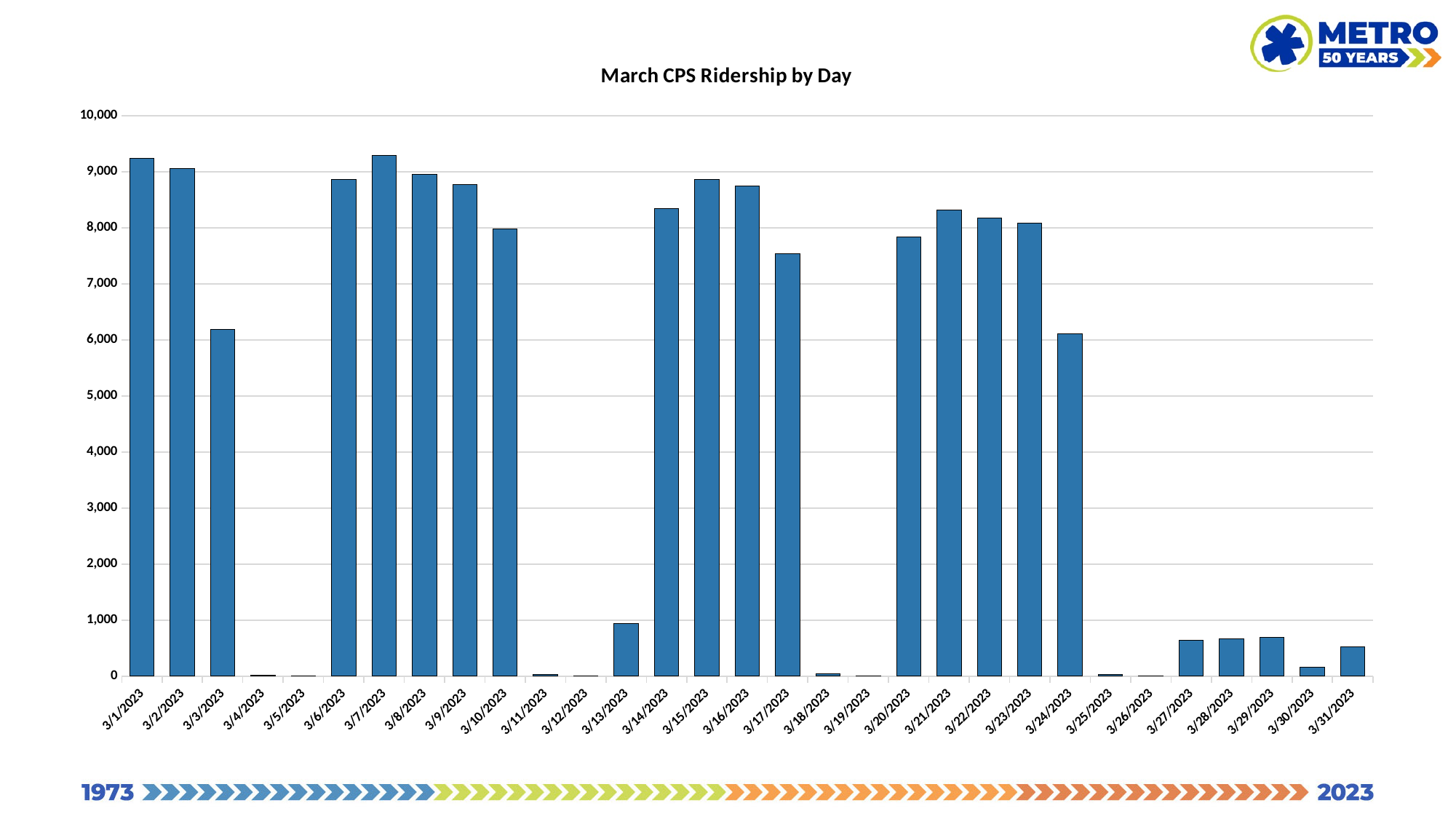
What kind of chart is shown on the slide? bar chart What is the title of the chart? March CPS Ridership by Day Is the value for 3/3/2023 greater or less than 6,000? greater Is the value for 3/17/2023 greater or less than 8,000? less Is the value for 3/14/2023 greater or less than 8,000? greater How many days (categories) are plotted on the x axis? 31 Do the values rise or fall from 3/1/2023 to 3/3/2023? fall Which is larger, the value for 3/13/2023 or the value for 3/14/2023? 3/14/2023 Which is larger, the value for 3/1/2023 or the value for 3/3/2023? 3/1/2023